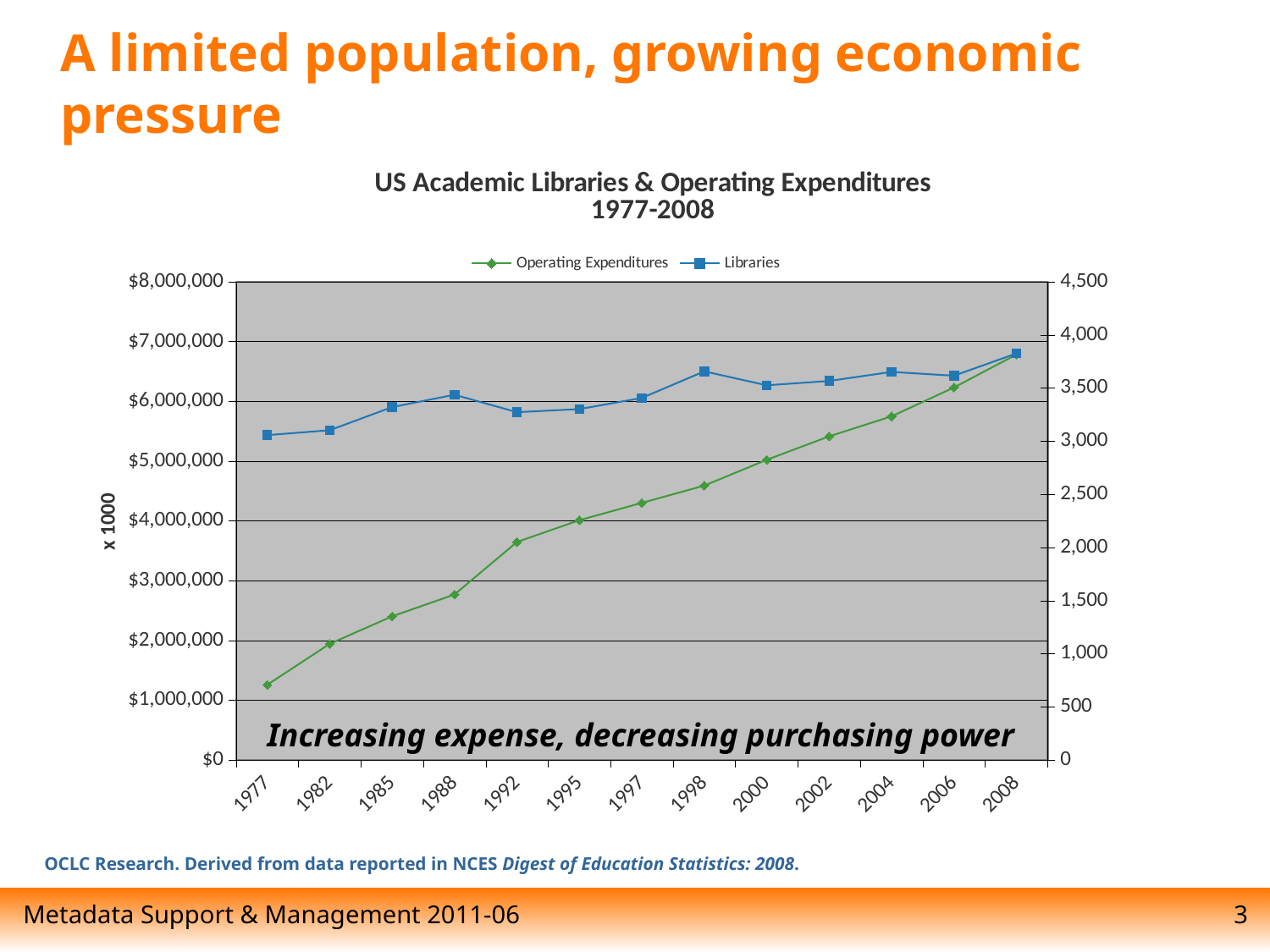
In which year is Operating Expenditures lowest? 1977 How many years are plotted along the x axis? 13 Is the Libraries value for 1998 greater or less than 3,500? greater In which year is Operating Expenditures highest? 2008 How many series does the legend list? 2 Is the Operating Expenditures value for 2008 greater or less than $6,000,000? greater What kind of chart is shown on the slide? Line chart Is the Operating Expenditures value for 1977 greater or less than $2,000,000? less What is the title of the chart? US Academic Libraries & Operating Expenditures 1977-2008 Do the Operating Expenditures values rise or fall from 1977 to 2008? Rise In which year is the Libraries series lowest? 1977